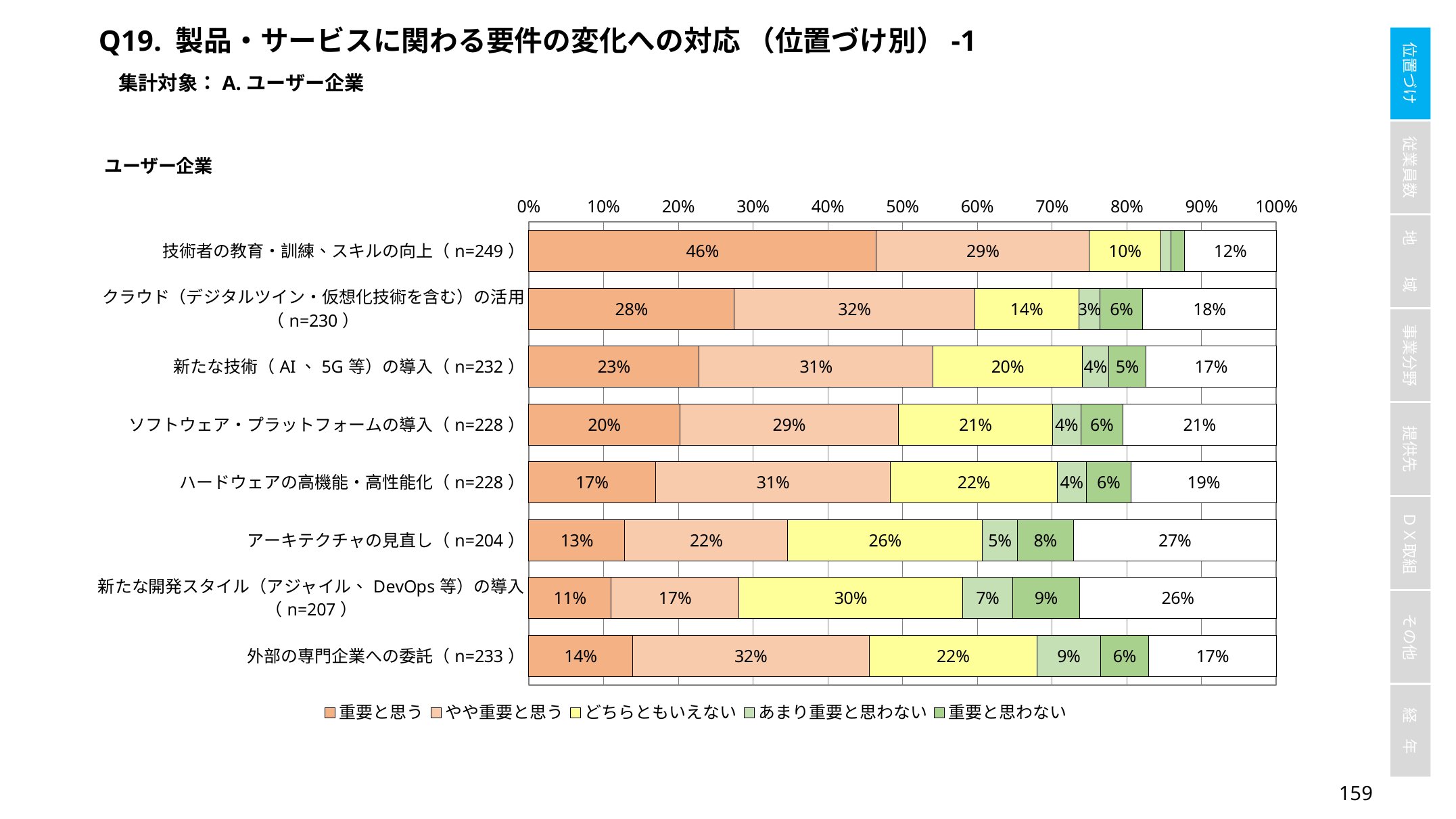
What type of chart is shown on the slide? Stacked bar chart What is the どちらともいえない value for 新たな開発スタイル（アジャイル、DevOps等）の導入? 30% What is the sample size (n) shown for ソフトウェア・プラットフォームの導入? n=228 Which category has the lowest 重要と思う value? 新たな開発スタイル（アジャイル、DevOps等）の導入 What is the 重要と思わない value for アーキテクチャの見直し? 8% What is the difference between the 重要と思う values for クラウド（デジタルツイン・仮想化技術を含む）の活用 and 新たな技術（AI、5G等）の導入? 5% What is the あまり重要と思わない value for 外部の専門企業への委託? 9% Which is larger: the やや重要と思う value for ハードウェアの高機能・高性能化 or for アーキテクチャの見直し? ハードウェアの高機能・高性能化 How many series does the legend list? 5 How many categories (items) are plotted on the chart? 8 Which category has the highest 重要と思う value? 技術者の教育・訓練、スキルの向上 What is the 重要と思う value for 技術者の教育・訓練、スキルの向上? 46%